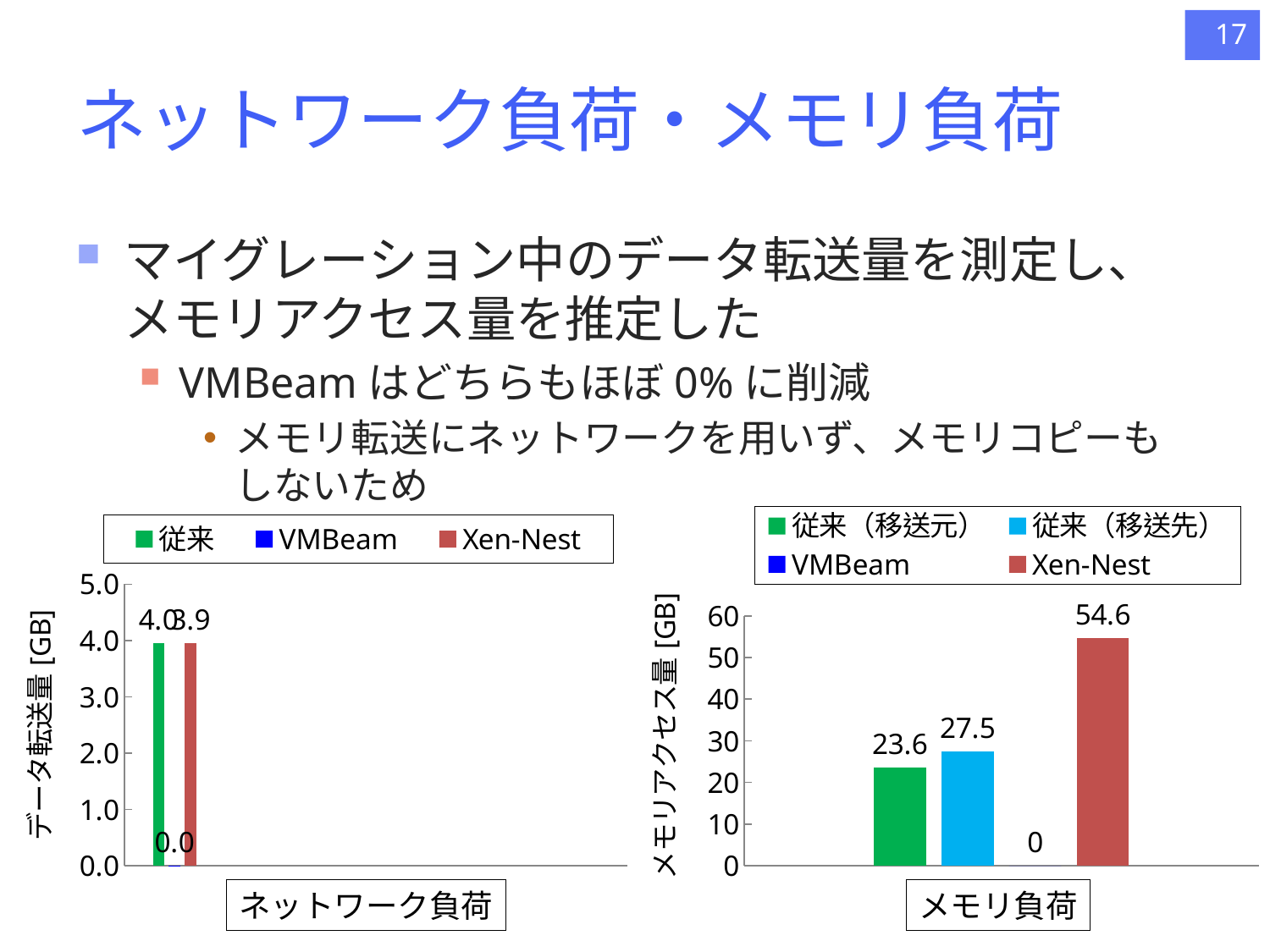
In the ネットワーク負荷 chart, is the value for 従来 greater or less than 3.0? greater In the メモリ負荷 chart, what is the difference between Xen-Nest and 従来（移送先）? 27.1 How many series does the legend of the ネットワーク負荷 chart list? 3 In the メモリ負荷 chart, what is the value for Xen-Nest? 54.6 What type of chart is the ネットワーク負荷 chart? bar chart How many series does the legend of the メモリ負荷 chart list? 4 In the ネットワーク負荷 chart, what is the value for VMBeam? 0.0 In the メモリ負荷 chart, what is the value for 従来（移送元）? 23.6 In the メモリ負荷 chart, what is the value for 従来（移送先）? 27.5 In the メモリ負荷 chart, which series has the highest value? Xen-Nest In the メモリ負荷 chart, which is larger, 従来（移送元） or 従来（移送先）? 従来（移送先） In the メモリ負荷 chart, what is the value for VMBeam? 0